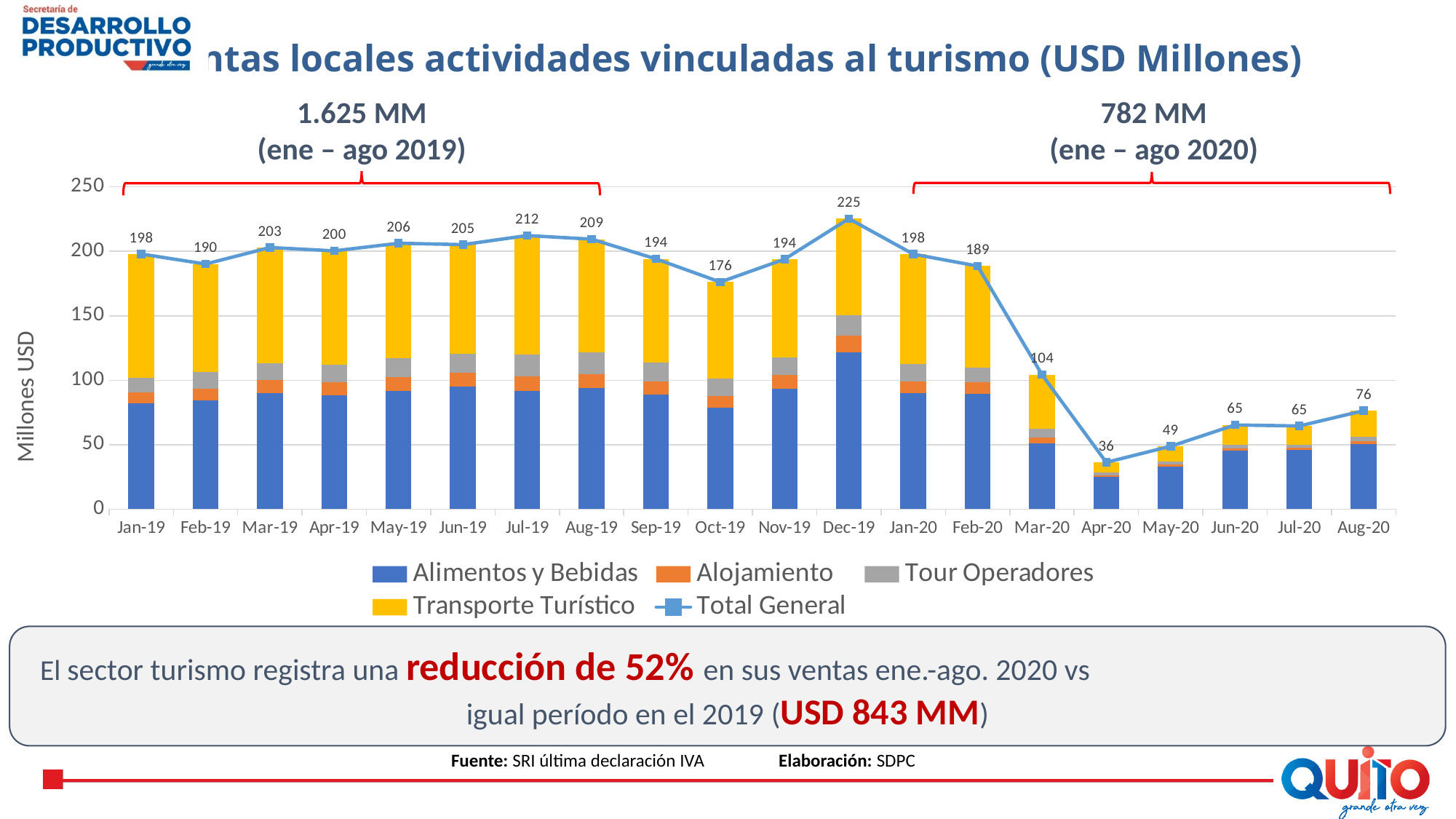
Do the Total General values rise or fall from Feb-20 to Apr-20? fall What is the Total General value for Dec-19? 225 How many series does the legend list? 5 What is the Total General value for Apr-20? 36 What is the difference between the Total General values for Jan-20 and Feb-20? 9 How many months are shown on the x axis? 20 What kind of chart is shown on the slide? Stacked bar chart with a line Which month has the highest Total General value? Dec-19 Which month has the lowest Total General value? Apr-20 Which is larger, the Total General value for Jul-19 or for Aug-19? Jul-19 Is the Alimentos y Bebidas value for Dec-19 greater or less than 100? greater What is the Total General value for Mar-20? 104